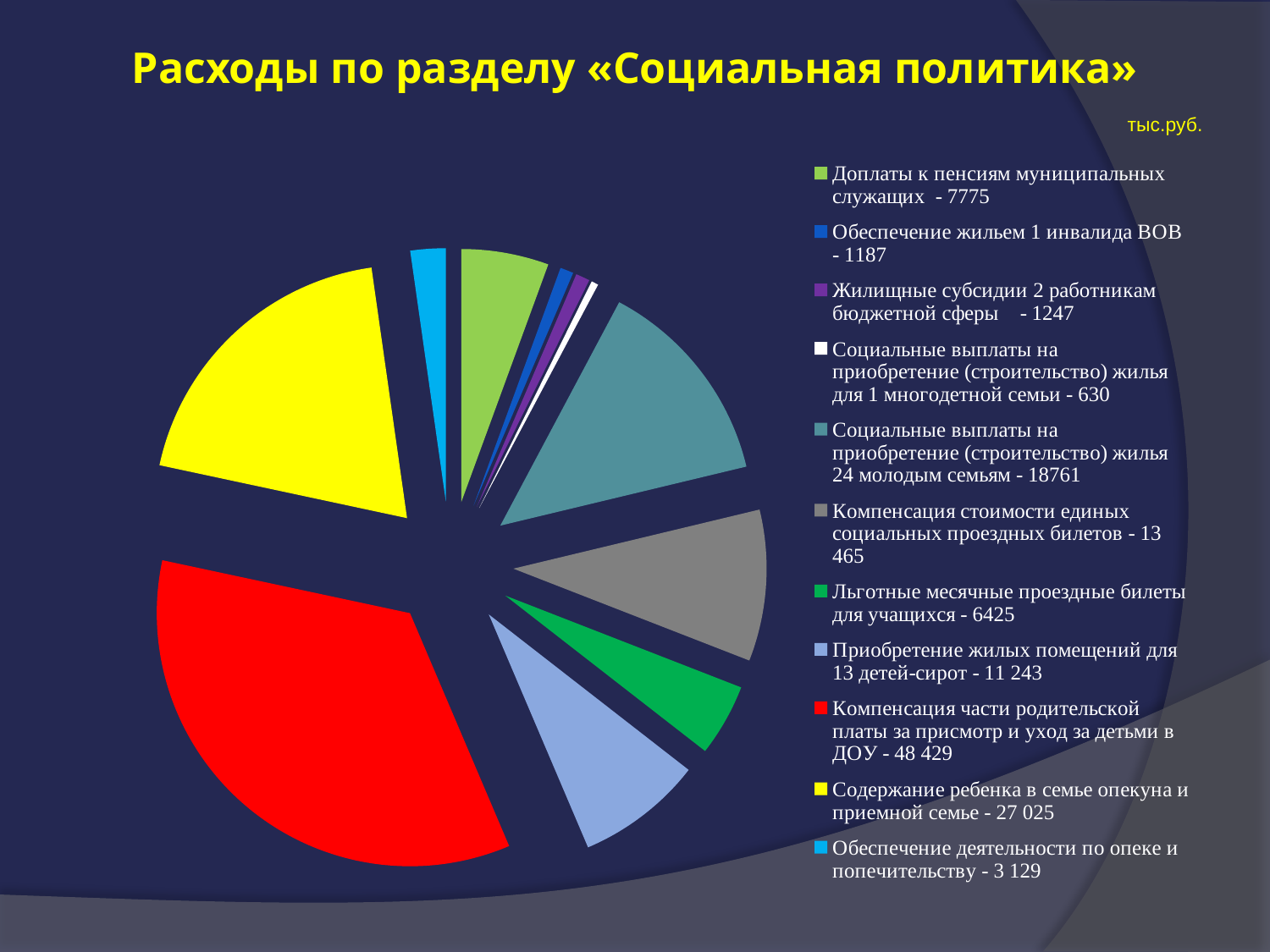
Which is larger: the value for «Компенсация стоимости единых социальных проездных билетов» or for «Приобретение жилых помещений для 13 детей-сирот»? Компенсация стоимости единых социальных проездных билетов What is the value for «Компенсация части родительской платы за присмотр и уход за детьми в ДОУ»? 48 429 What is the value for «Социальные выплаты на приобретение (строительство) жилья 24 молодым семьям»? 18761 What is the title of the chart on the slide? Расходы по разделу «Социальная политика» Which category has the largest value in the pie chart? Компенсация части родительской платы за присмотр и уход за детьми в ДОУ How many categories does the pie chart legend list? 11 What is the value for «Содержание ребенка в семье опекуна и приемной семье»? 27 025 In what units are the values on the slide given? тыс.руб. What kind of chart is shown on the slide? pie chart What is the difference between the values for «Компенсация части родительской платы за присмотр и уход за детьми в ДОУ» and «Содержание ребенка в семье опекуна и приемной семье»? 21 404 What is the value for «Обеспечение деятельности по опеке и попечительству»? 3 129 Which category has the smallest value in the pie chart? Социальные выплаты на приобретение (строительство) жилья для 1 многодетной семьи